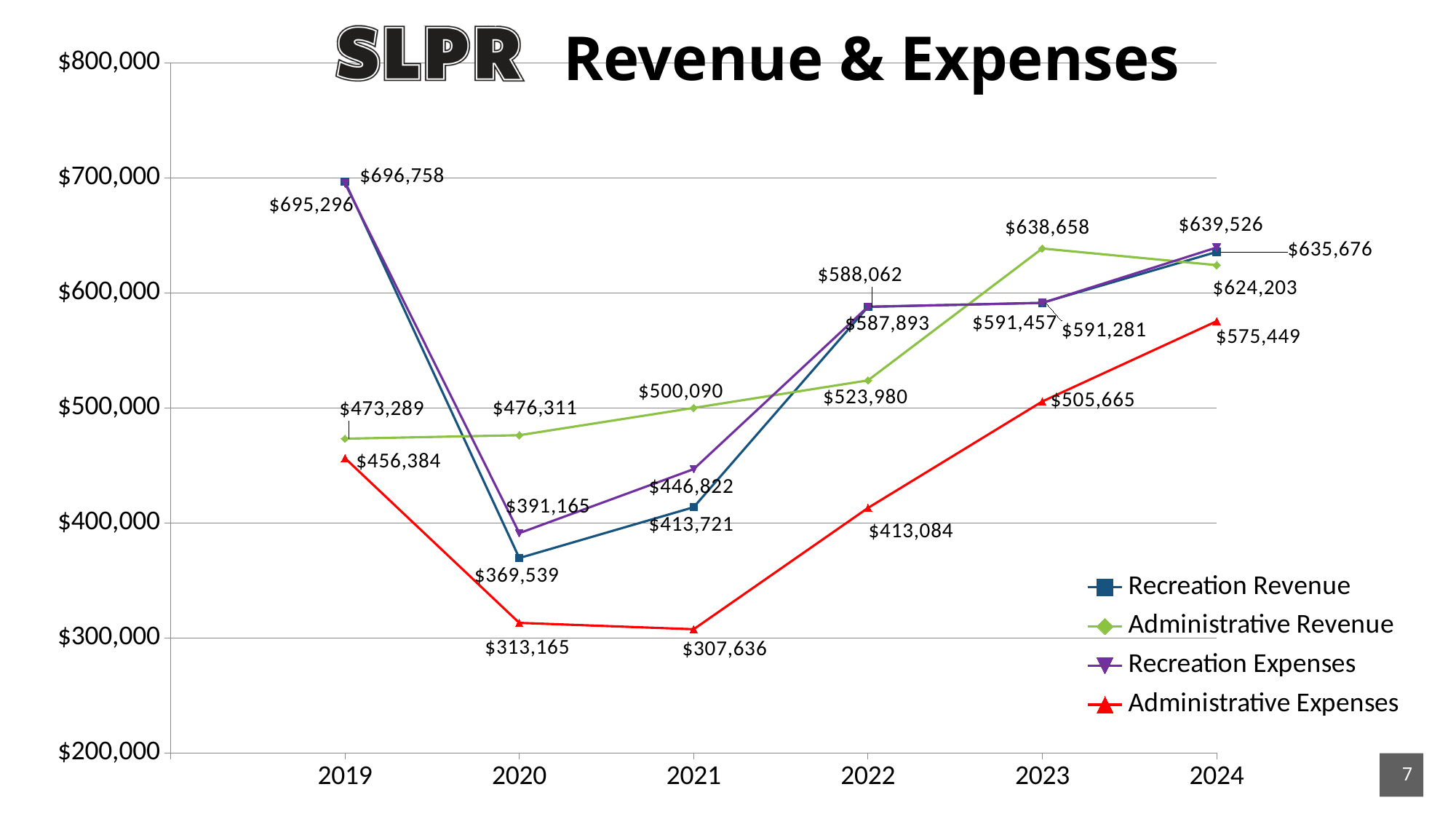
In which year is Administrative Revenue at its highest? 2023 What is the Recreation Revenue value for 2020? $369,539 What is the Administrative Revenue value for 2023? $638,658 How many years are plotted along the x axis? 6 In 2020, which is larger: Administrative Revenue or Administrative Expenses? Administrative Revenue What is the difference between Administrative Expenses in 2024 and in 2023? $69,784 What type of chart is shown on the slide? Line chart What is the Administrative Expenses value for 2021? $307,636 Do Administrative Expenses rise or fall from 2021 to 2024? Rise In which year is Administrative Expenses at its lowest? 2021 What is the Recreation Expenses value for 2021? $446,822 How many series does the legend list? 4